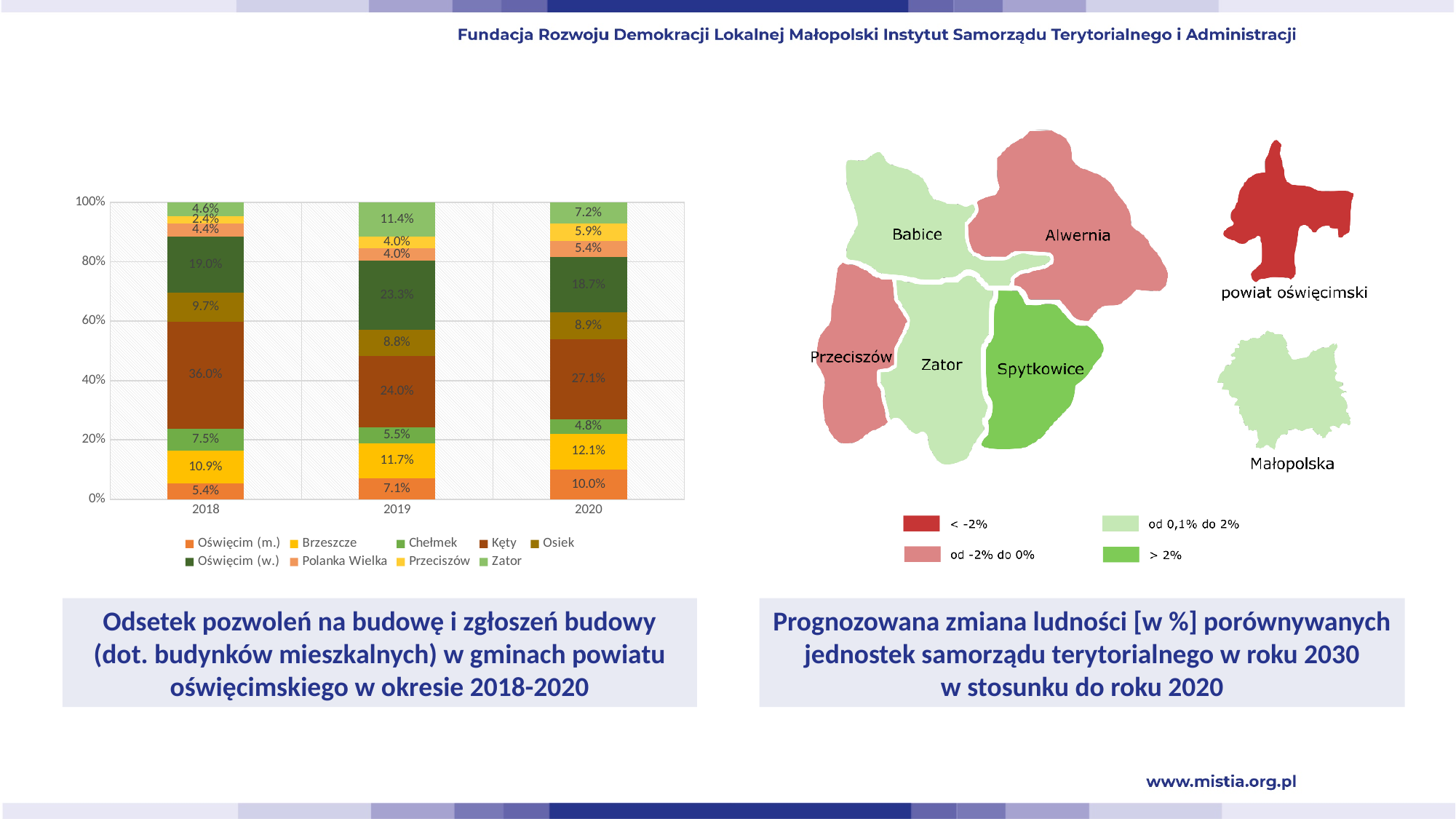
What is the difference between the Kęty values for 2018 and 2019 in the bar chart? 12.0 percentage points How many years are shown on the x axis of the bar chart? 3 Which municipality has the largest share in the 2020 bar of the chart? Kęty Which municipality has the smallest share in the 2018 bar of the chart? Przeciszów In the bar chart, is the 2019 value for Oświęcim (w.) larger or smaller than the 2019 value for Kęty? Smaller Does the value for Brzeszcze rise or fall from 2018 to 2020 in the bar chart? Rises What is the value for Zator in 2019 in the bar chart? 11.4% What is the value for Oświęcim (m.) in 2020 in the bar chart? 10.0% How many series does the legend of the bar chart list? 9 What is the value for Kęty in 2018 in the bar chart? 36.0% Which year is shown in the middle bar of the chart? 2019 What kind of chart is shown on the left side of the slide? Stacked bar chart